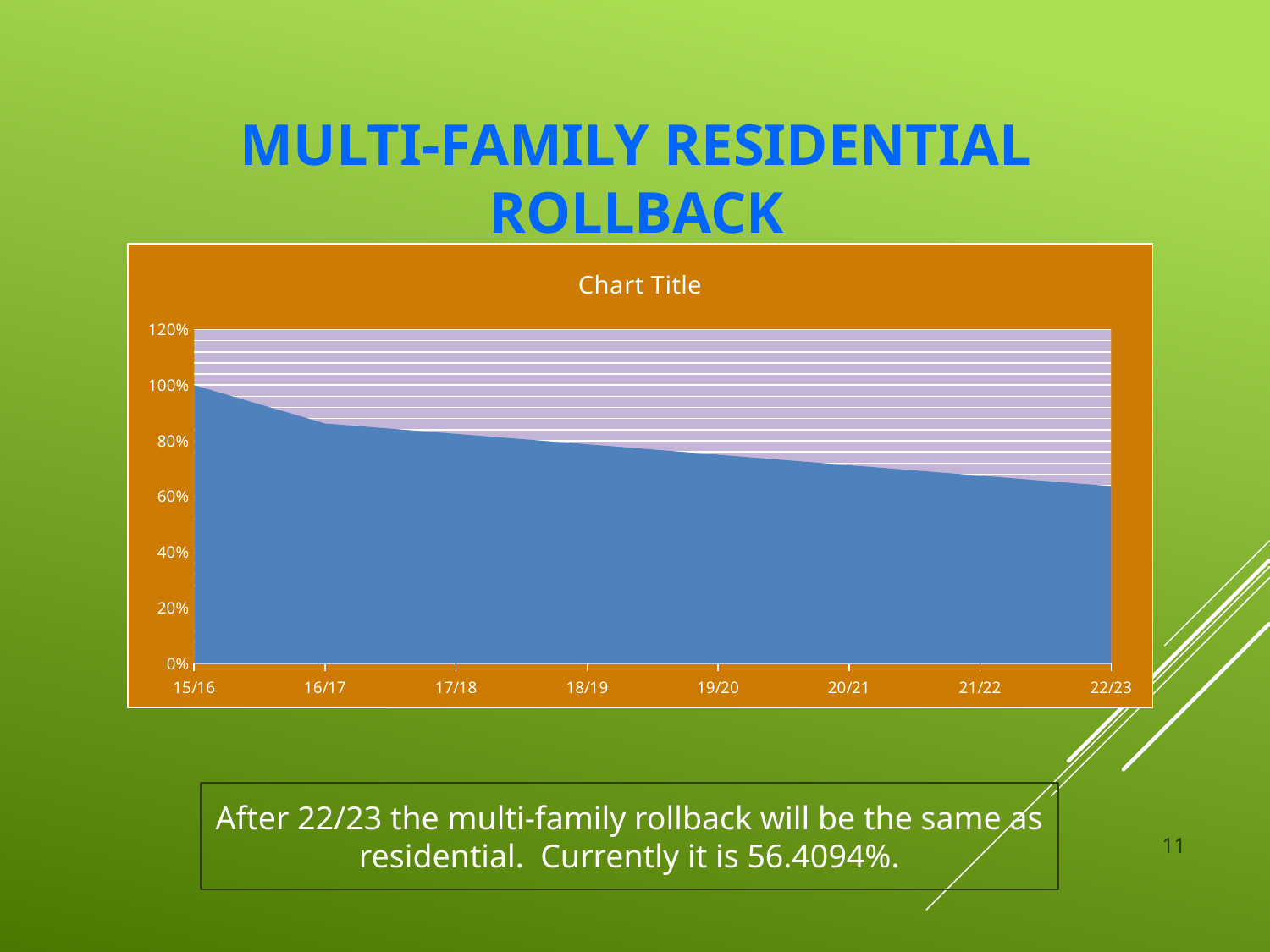
Which is larger, the value for 16/17 or the value for 21/22? 16/17 Is the value for 22/23 greater or less than 80%? less How many fiscal years are plotted along the x axis of the chart? 8 Do the plotted values rise or fall from 15/16 to 22/23? fall What kind of chart is shown on the slide? area chart Is the value for 19/20 greater or less than 60%? greater What is the title shown above the chart? Chart Title Is the value for 21/22 greater or less than 80%? less Which year has the lowest value in the chart? 22/23 Which year has the highest value in the chart? 15/16 What is the value for 15/16 in the chart? 100%